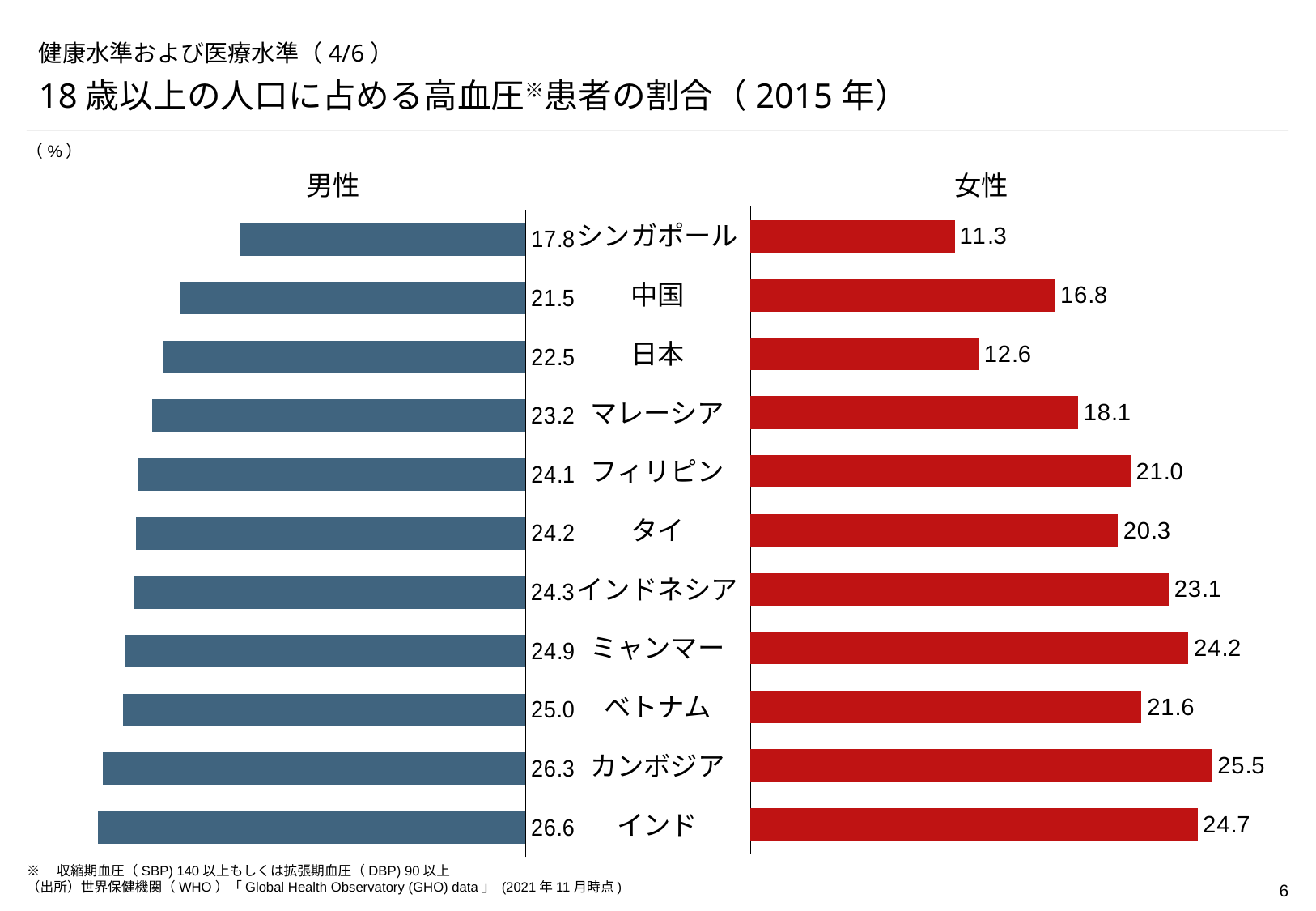
In the 女性 chart, which is larger, the value for 中国 or the value for 日本? 中国 In the 女性 chart, what is the value for マレーシア? 18.1 In the 男性 chart, what is the value for 日本? 22.5 What unit is indicated for the values on the slide? % In the 女性 chart, which country has the lowest value? シンガポール In the 男性 chart, which country has the highest value? インド In the 男性 chart, what is the difference between the values for インド and シンガポール? 8.8 In the 女性 chart, what is the value for ベトナム? 21.6 What is the difference between the 男性 and 女性 values for 日本? 9.9 How many countries are shown in the 男性 chart? 11 What type of chart is the 女性 chart? bar chart In the 女性 chart, which country has the highest value? カンボジア